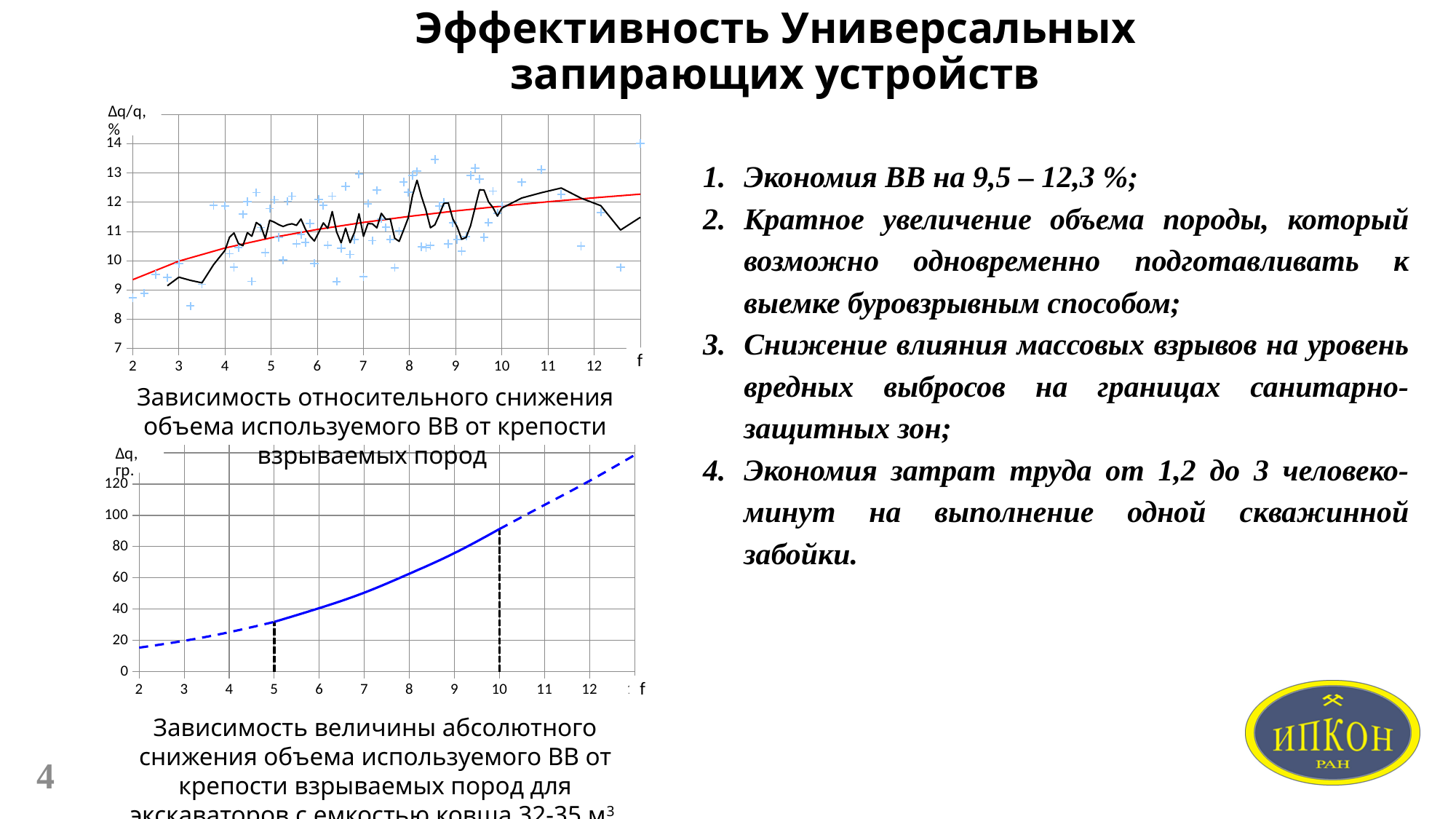
In the bottom chart (Δq, гр. versus f), is the value of the curve at f = 12 greater or less than 100? greater In the bottom chart (Δq, гр. versus f), is the value of the curve at f = 2 greater or less than 20? less What is the label on the vertical axis of the top chart? Δq/q, % What kind of chart is the bottom chart on the slide (Δq, гр. versus f)? line chart In the bottom chart (Δq, гр. versus f), is the value of the curve at f = 10 greater or less than 80? greater In the bottom chart (Δq, гр. versus f), do the values rise or fall as f increases? rise How many charts are shown on the slide? 2 In the top chart (Δq/q, % versus f), does the red trend line rise or fall as f increases? rise What kind of chart is the top chart on the slide (Δq/q, % versus f)? line chart